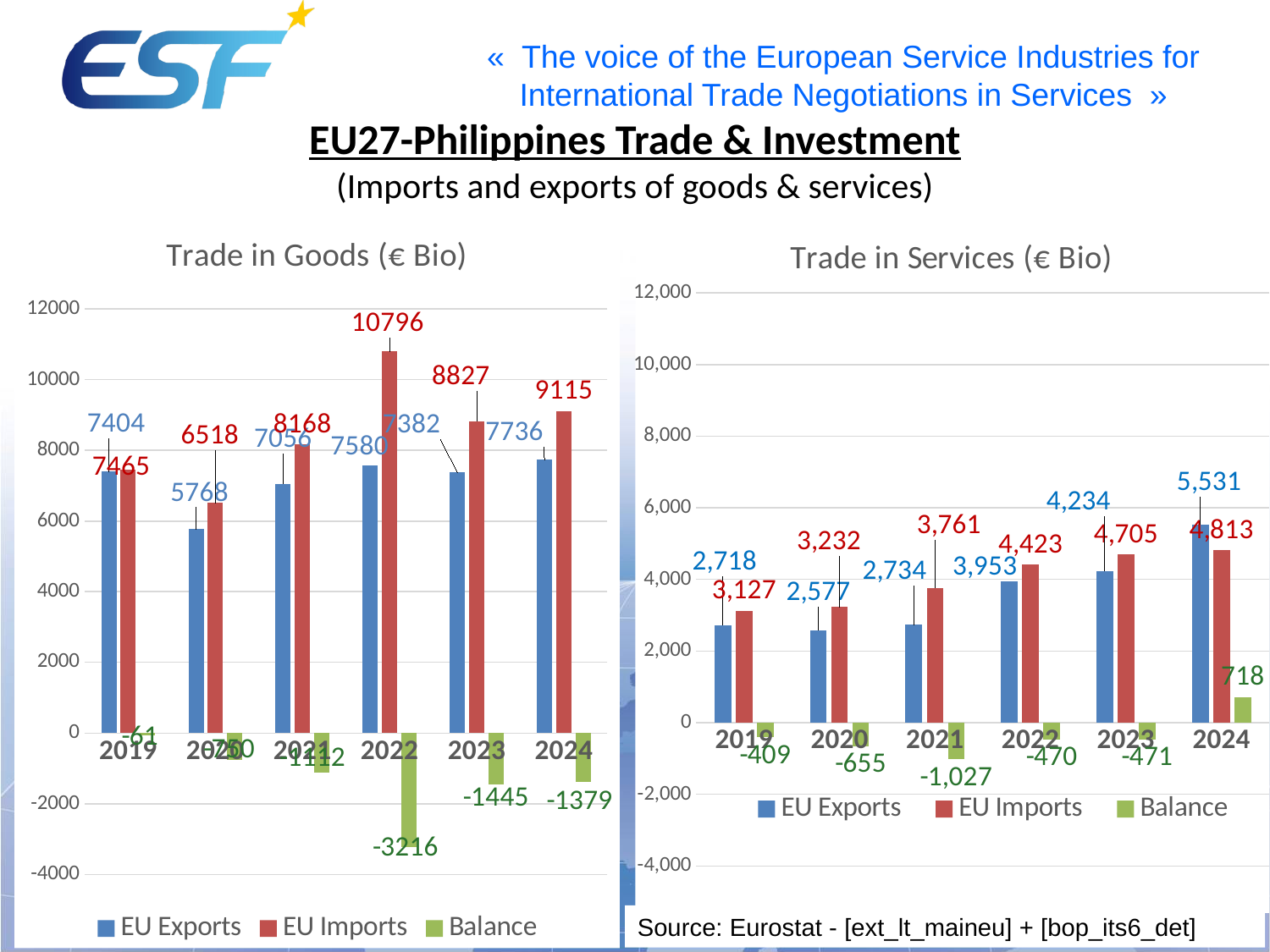
What type of chart is the Trade in Services chart? Bar chart How many years are shown on the x axis of the Trade in Goods chart? 6 In the Trade in Goods chart, which year has the lowest EU Exports value? 2020 In the Trade in Services chart, what is the value of EU Exports in 2024? 5,531 In the Trade in Goods chart, what is the value of EU Imports in 2022? 10796 In the Trade in Services chart, which year has the lowest Balance value? 2021 How many series does the legend of the Trade in Services chart list? 3 In the Trade in Services chart, which is larger in 2024, EU Exports or EU Imports? EU Exports In the Trade in Services chart, what is the Balance value for 2020? -655 In the Trade in Goods chart, what is the difference between EU Imports and EU Exports in 2024? 1379 In the Trade in Goods chart, what is the Balance value for 2023? -1445 In the Trade in Goods chart, which year has the highest EU Imports value? 2022